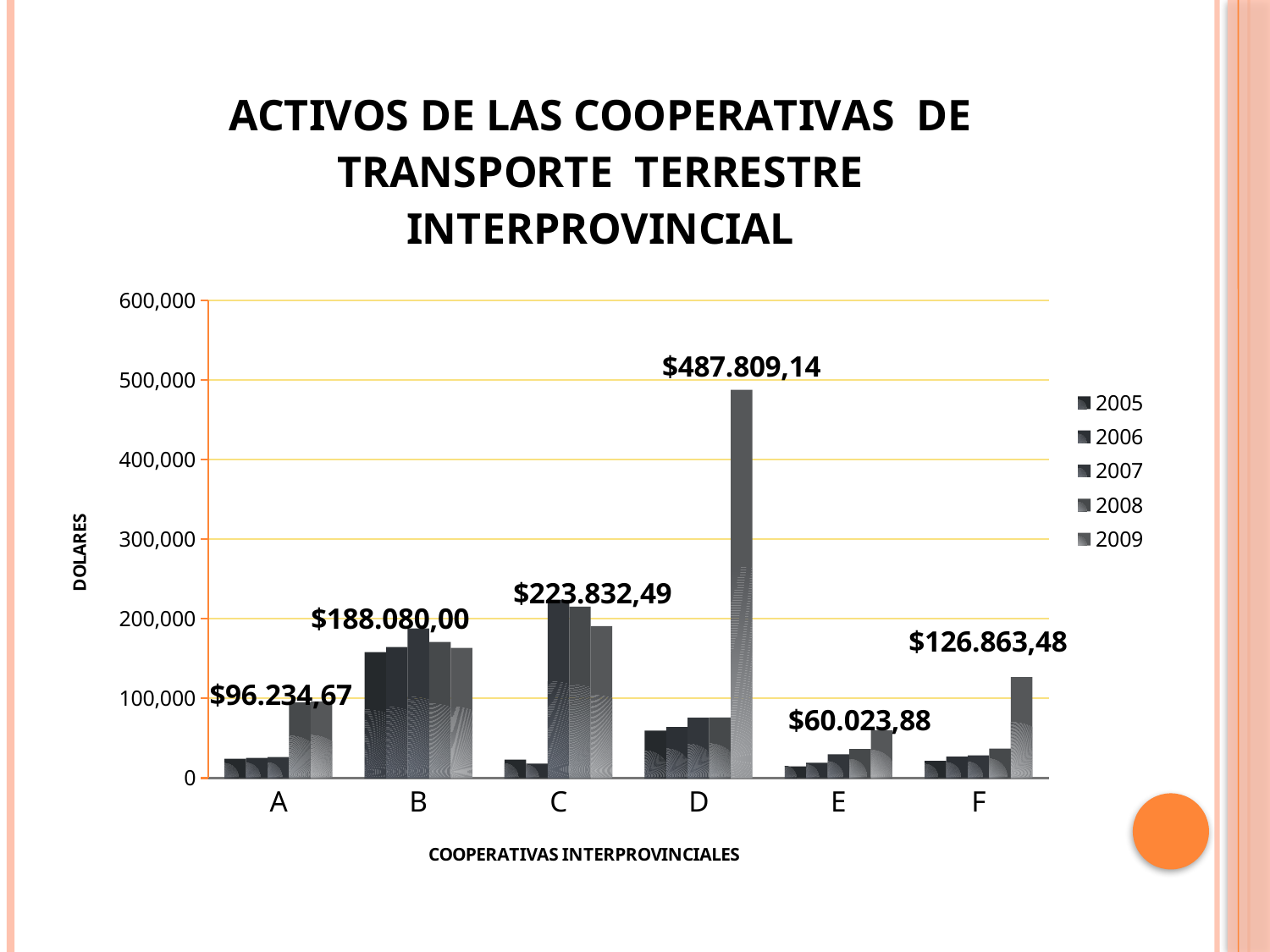
What kind of chart is shown on the slide? bar chart What is the value labelled above cooperative D? $487.809,14 Is the 2009 value for cooperative D greater or less than 400,000? greater How many series does the legend list? 5 What is the value labelled above cooperative E? $60.023,88 How many cooperatives (categories) are shown on the x axis? 6 What is the value labelled above cooperative C? $223.832,49 What is the difference between the labelled values for cooperatives D and C? $263.976,65 What is the value labelled above cooperative B? $188.080,00 What is the value labelled above cooperative F? $126.863,48 Which cooperative has the tallest bar in the chart? D What is the title of the vertical axis? DOLARES